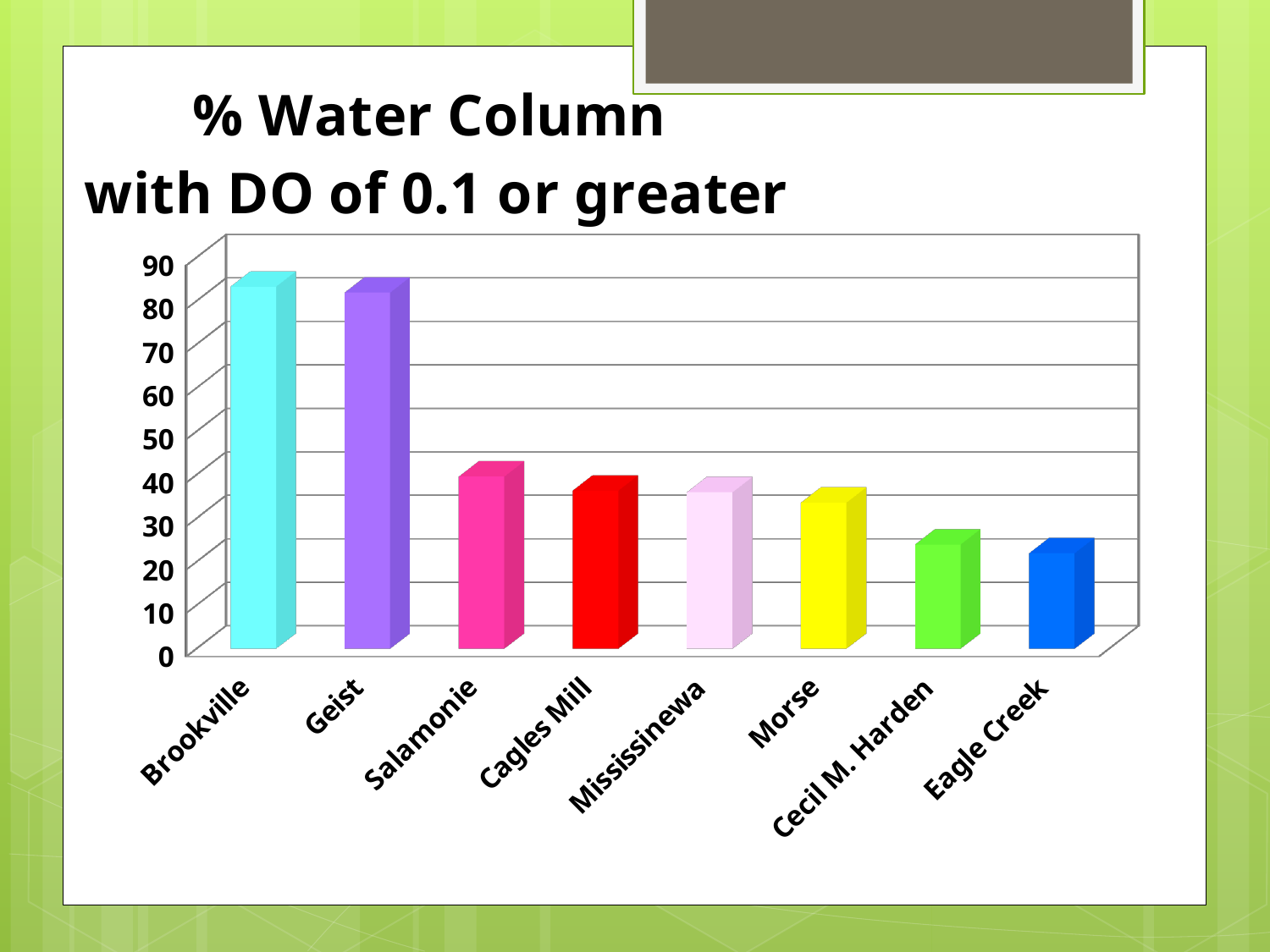
What kind of chart is shown on the slide? bar chart How many reservoirs (categories) are shown on the x axis? 8 Is the value for Eagle Creek greater or less than 30? less Is the value for Geist greater or less than 70? greater Which reservoir has the lowest % water column with DO of 0.1 or greater? Eagle Creek What is the title of the chart? % Water Column with DO of 0.1 or greater Is the value for Brookville greater or less than 70? greater Which has a larger value, Geist or Cagles Mill? Geist Do the values generally rise or fall moving from left to right along the x axis? fall Which has a larger value, Salamonie or Eagle Creek? Salamonie